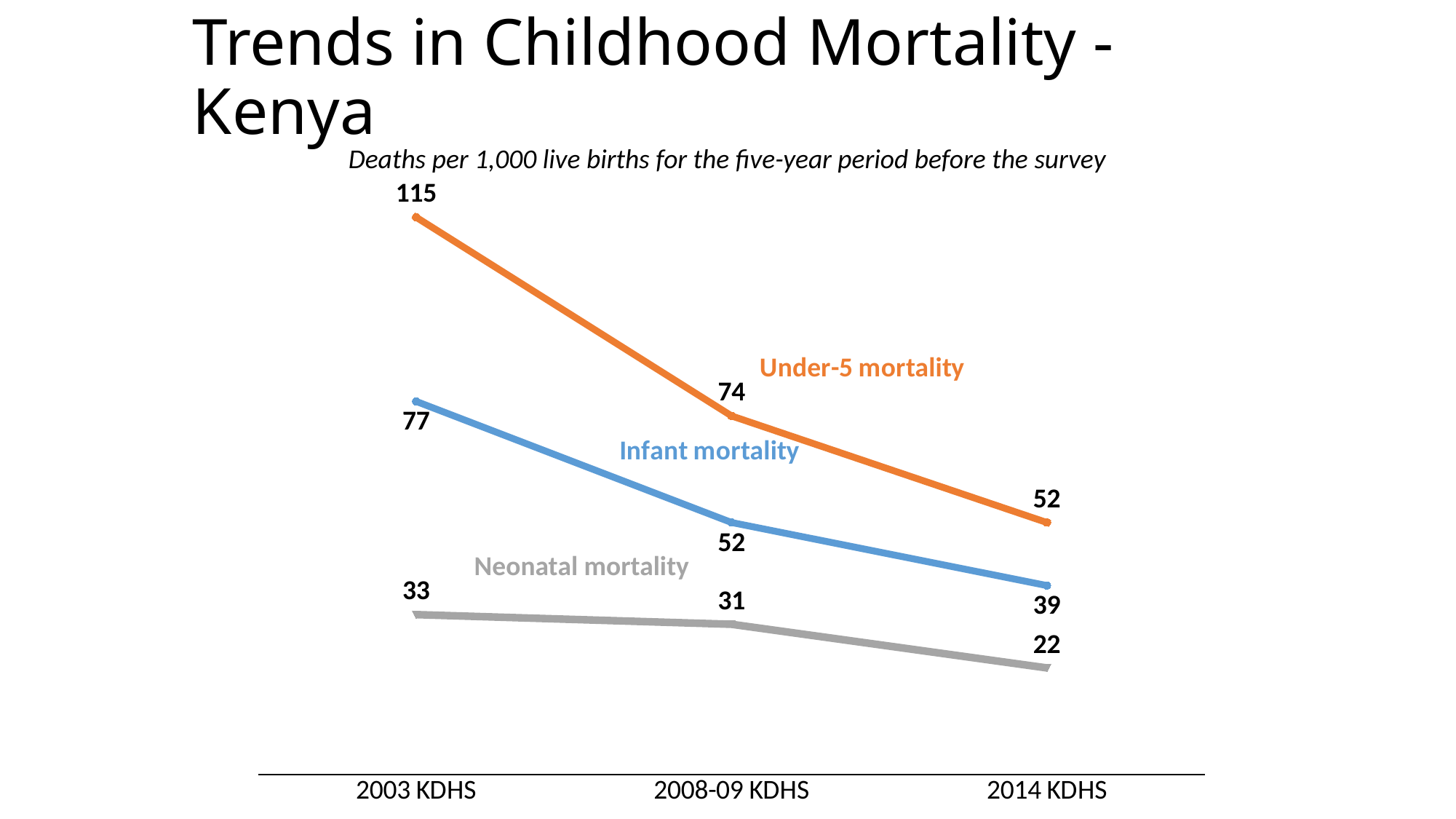
What is the neonatal mortality value for the 2008-09 KDHS? 31 How many surveys are shown on the x axis? 3 What is the difference between infant mortality and neonatal mortality in the 2008-09 KDHS? 21 Which survey has the lowest neonatal mortality? 2014 KDHS What is the infant mortality value for the 2014 KDHS? 39 What is the under-5 mortality value for the 2003 KDHS? 115 Which is larger in the 2014 KDHS: under-5 mortality or infant mortality? Under-5 mortality How many series are plotted on the chart? 3 Do the infant mortality values rise or fall from the 2003 KDHS to the 2014 KDHS? Fall Which survey has the highest under-5 mortality? 2003 KDHS What kind of chart is shown on the slide? Line chart By how much did under-5 mortality fall between the 2003 KDHS and the 2014 KDHS? 63